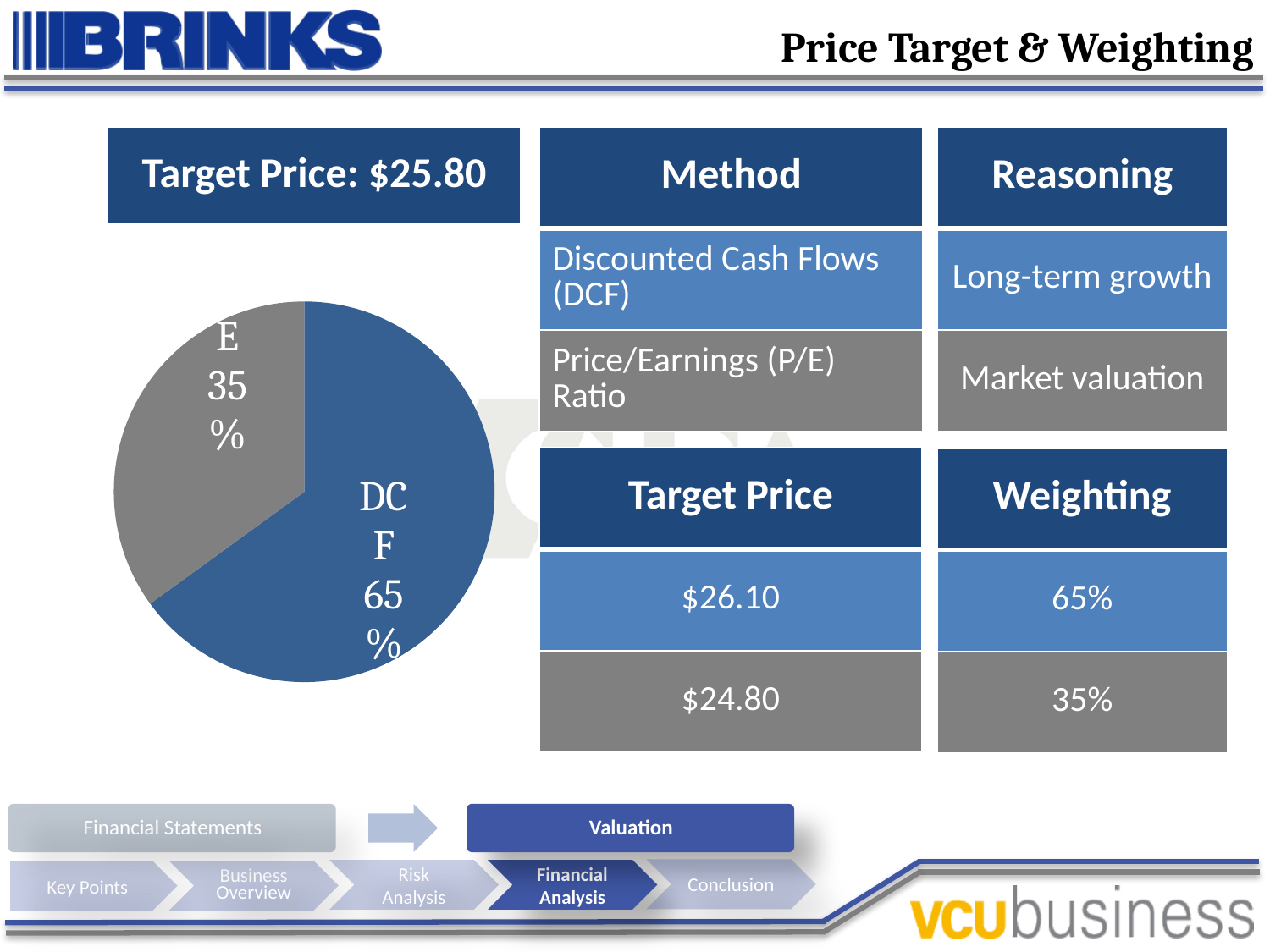
What kind of chart is shown on the slide? pie chart What colour is the DCF slice in the pie chart? blue What share of the pie chart does the grey slice labelled E represent? 35% Is the DCF slice of the pie chart greater or less than 50%? greater Which is larger in the pie chart, the DCF slice or the E slice? DCF How many slices does the pie chart have? 2 What share of the pie chart does the DCF slice represent? 65% What colour is the 35% slice in the pie chart? grey Which slice of the pie chart is the smallest? E By how many percentage points does the DCF slice exceed the E slice in the pie chart? 30 Which slice of the pie chart is the largest? DCF